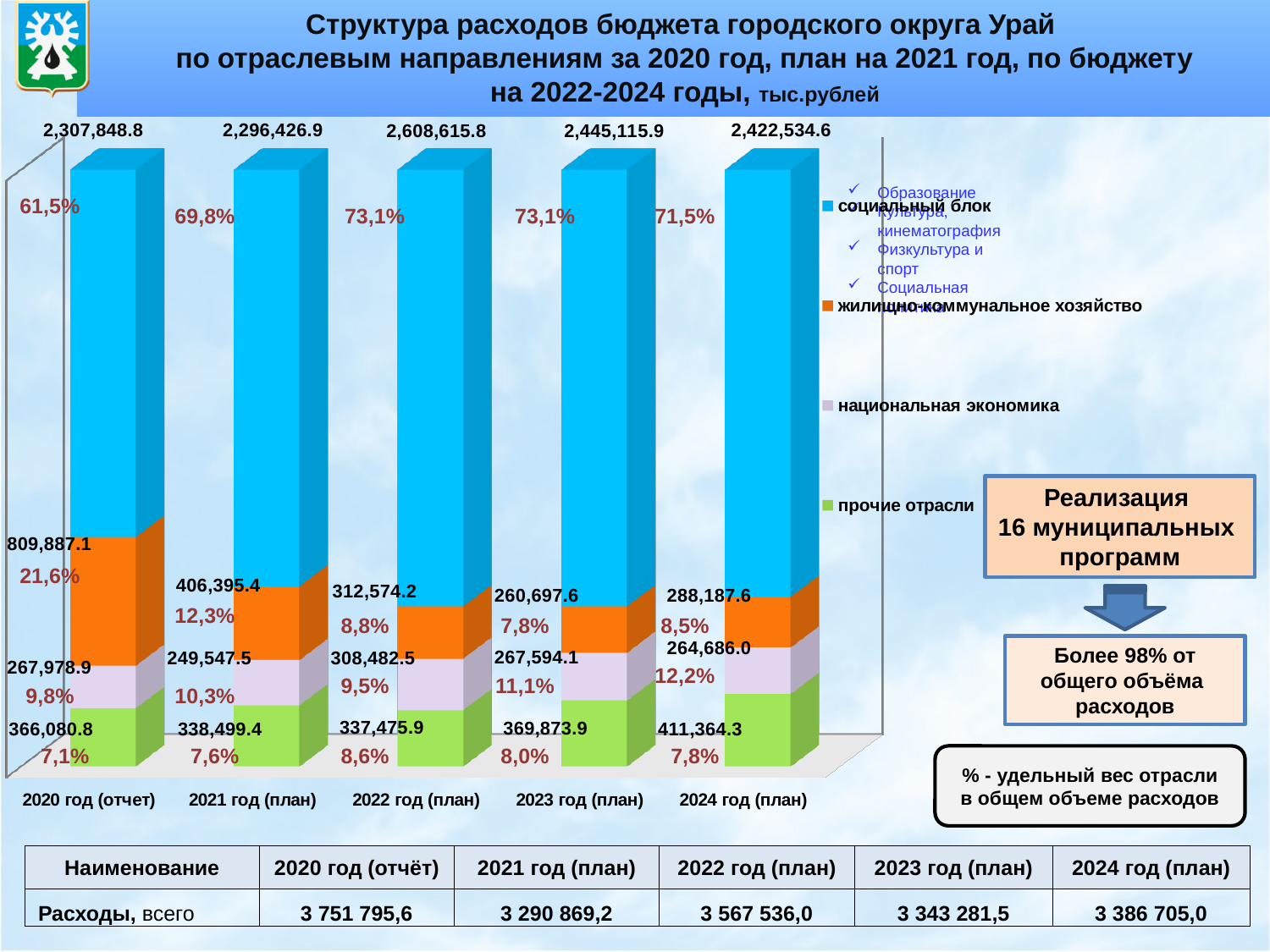
What is the value of социальный блок for 2022 год (план)? 2,608,615.8 In which year is the value of жилищно-коммунальное хозяйство the lowest? 2023 год (план) Which is larger: the прочие отрасли value for 2024 год (план) or for 2021 год (план)? 2024 год (план) How many series does the chart legend list? 4 What is the value of национальная экономика for 2021 год (план)? 249,547.5 What share of expenditures does жилищно-коммунальное хозяйство have in 2020 год (отчет)? 21,6% What is the difference between the жилищно-коммунальное хозяйство values for 2020 год (отчет) and 2021 год (план)? 403,491.7 How many years (categories) are shown on the x axis of the chart? 5 Does the share of социальный блок rise or fall from 2020 год (отчет) to 2022 год (план)? Rises What is the value of прочие отрасли for 2024 год (план)? 411,364.3 In which year is the value of социальный блок the highest? 2022 год (план) What kind of chart is shown on the slide? Stacked bar chart